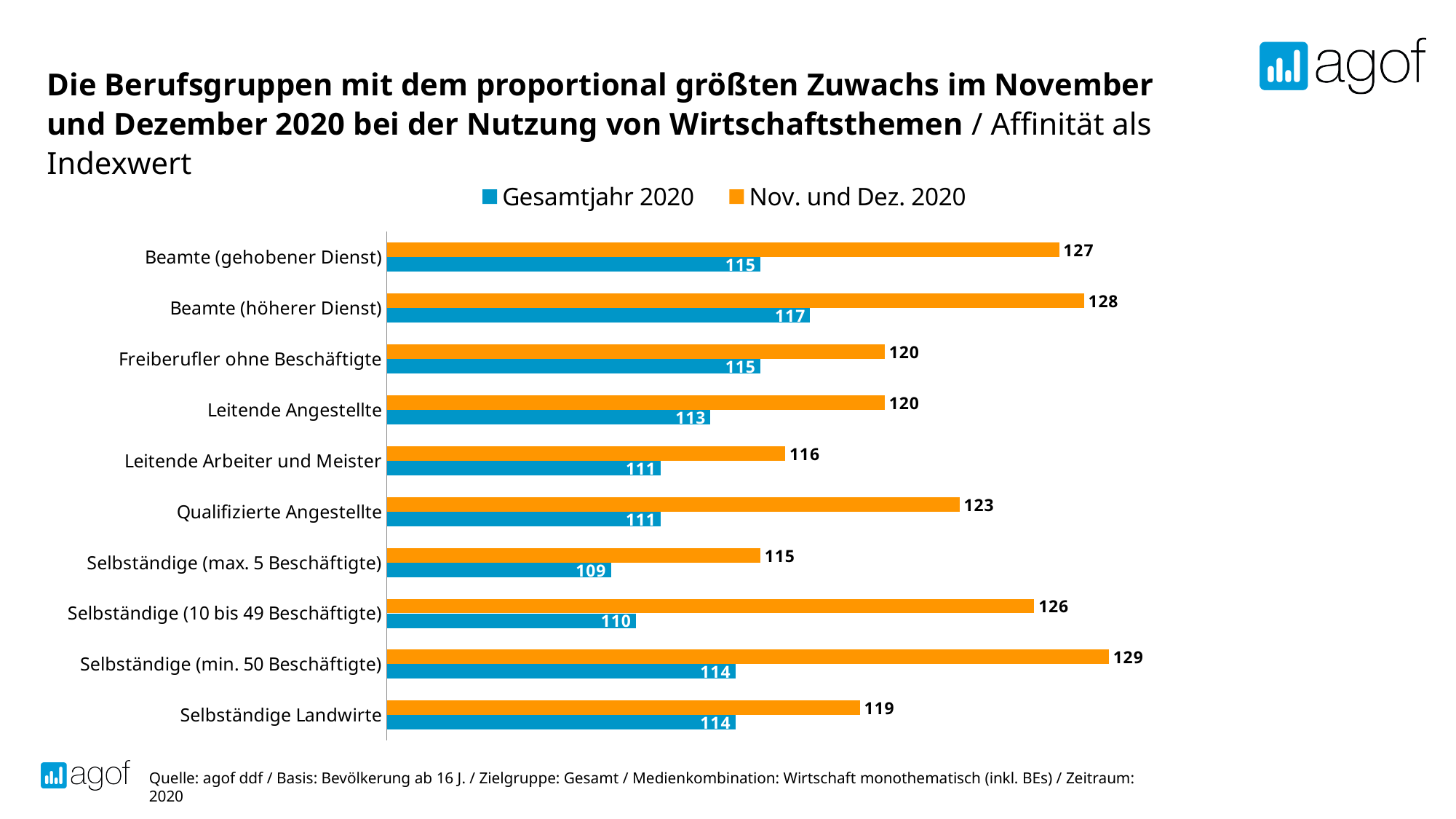
What is the Gesamtjahr 2020 value for Selbständige (max. 5 Beschäftigte)? 109 How many occupational groups (categories) are shown in the chart? 10 What is the difference between the Nov. und Dez. 2020 and Gesamtjahr 2020 values for Selbständige (10 bis 49 Beschäftigte)? 16 How many series does the legend list? 2 Which category has the highest Gesamtjahr 2020 value? Beamte (höherer Dienst) Which category has the lowest Nov. und Dez. 2020 value? Selbständige (max. 5 Beschäftigte) Which category has the highest Nov. und Dez. 2020 value? Selbständige (min. 50 Beschäftigte) What is the Gesamtjahr 2020 value for Leitende Arbeiter und Meister? 111 Which is larger: the Nov. und Dez. 2020 value for Qualifizierte Angestellte or for Leitende Angestellte? Qualifizierte Angestellte What is the Nov. und Dez. 2020 value for Beamte (höherer Dienst)? 128 What kind of chart is shown on the slide? Bar chart Which colour represents the Nov. und Dez. 2020 series? Orange